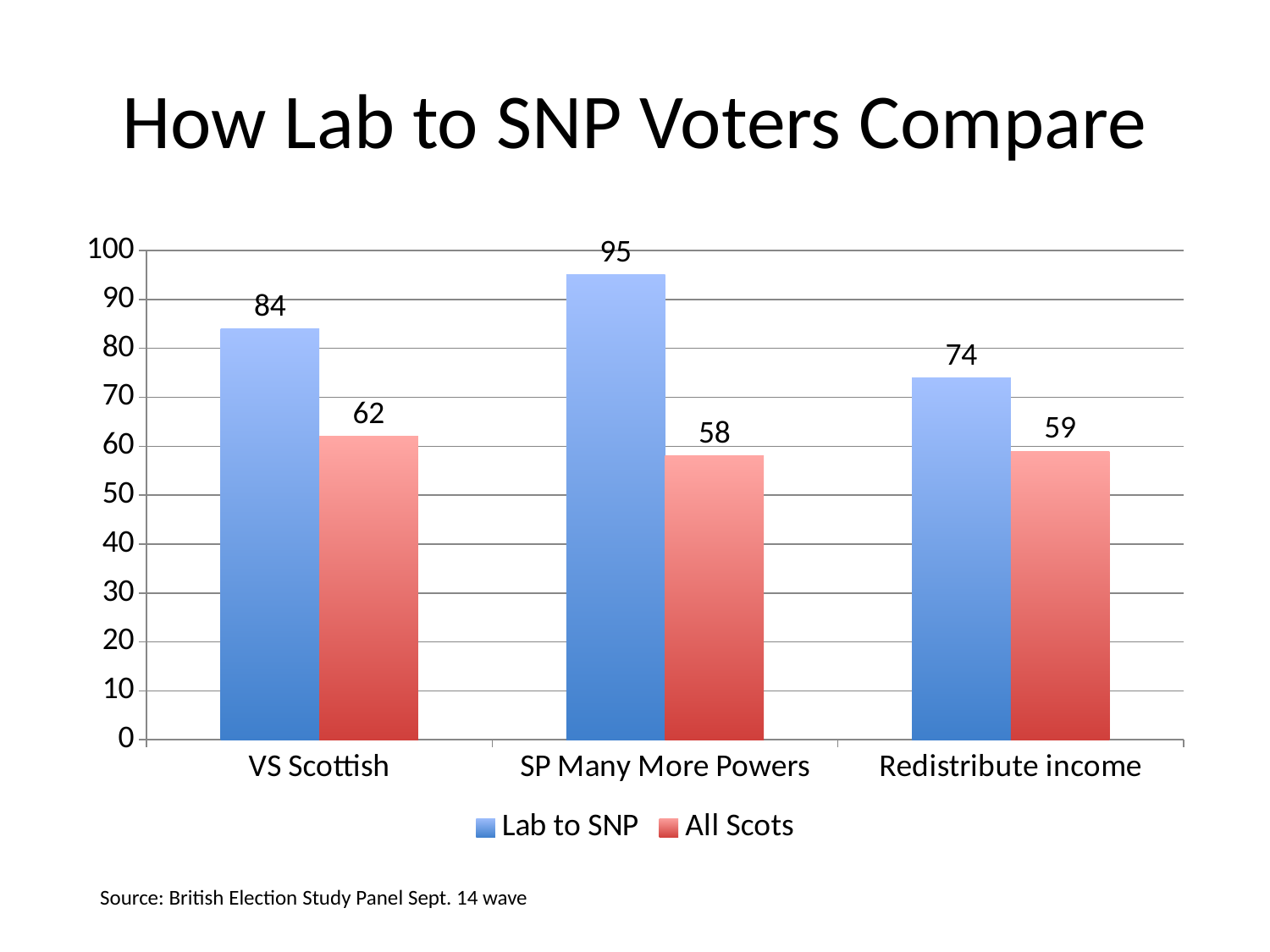
What is the value for Lab to SNP in the Redistribute income category? 74 How many categories are shown on the x axis? 3 Which category has the highest Lab to SNP value? SP Many More Powers What is the value for Lab to SNP in the VS Scottish category? 84 What is the difference between the Lab to SNP and All Scots values in the SP Many More Powers category? 37 What kind of chart is shown on the slide? Bar chart How many series does the legend list? 2 Which category has the lowest All Scots value? SP Many More Powers What is the value for All Scots in the SP Many More Powers category? 58 Which is larger in the Redistribute income category, Lab to SNP or All Scots? Lab to SNP What colour are the All Scots bars? Red What is the title of the chart? How Lab to SNP Voters Compare